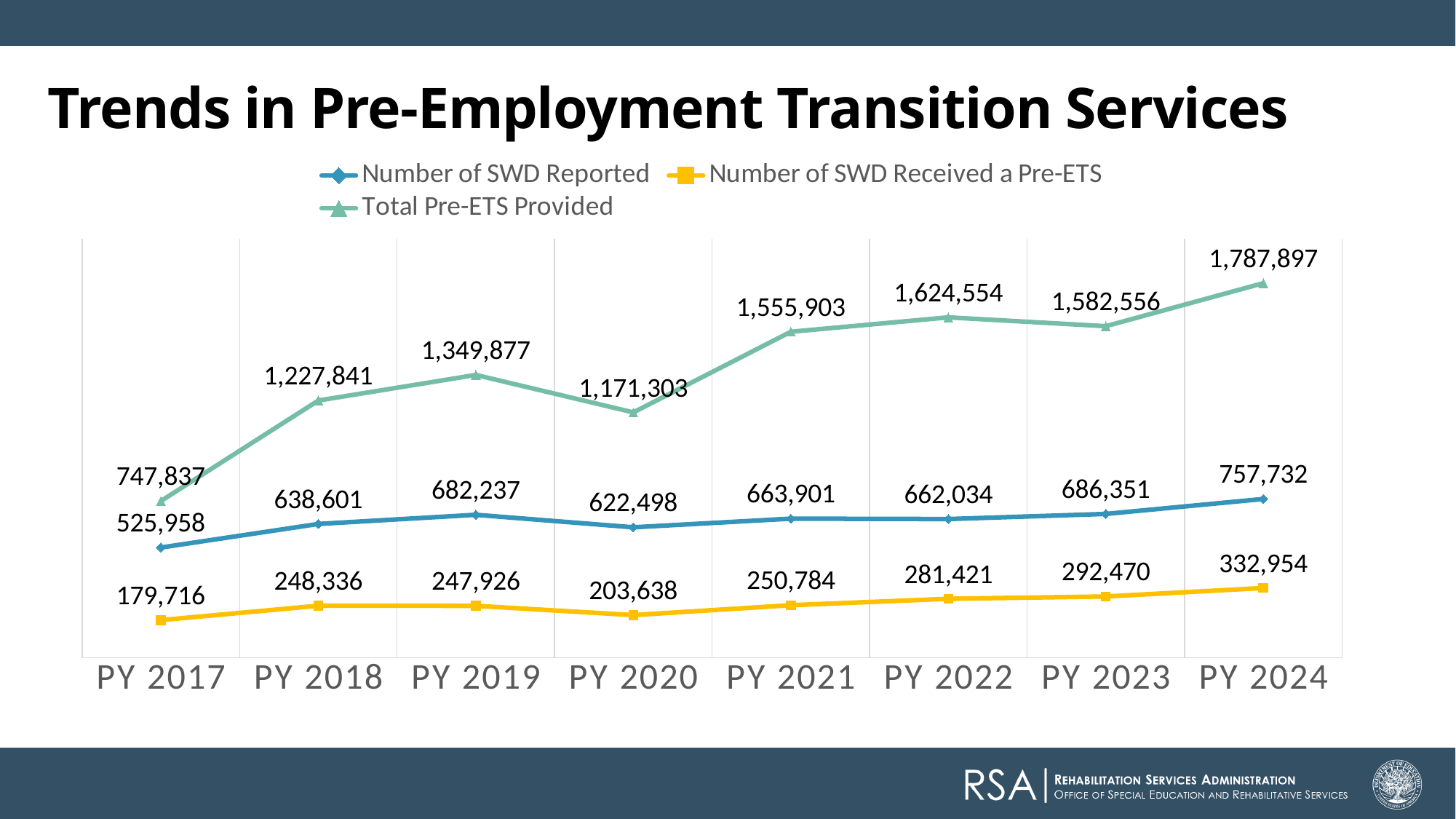
What is the Number of SWD Received a Pre-ETS in PY 2017? 179,716 What is the difference between the Number of SWD Reported in PY 2024 and in PY 2017? 231,774 Which is larger for Total Pre-ETS Provided: PY 2022 or PY 2023? PY 2022 How many program years are plotted on the x axis? 8 In which program year is the Number of SWD Received a Pre-ETS the lowest? PY 2017 What is the value of Total Pre-ETS Provided in PY 2024? 1,787,897 How many series does the legend list? 3 In which program year is Total Pre-ETS Provided the highest? PY 2024 What kind of chart is shown on the slide? Line chart What is the Number of SWD Reported in PY 2020? 622,498 What is the title of the slide? Trends in Pre-Employment Transition Services Does the Number of SWD Received a Pre-ETS rise or fall from PY 2020 to PY 2024? Rise